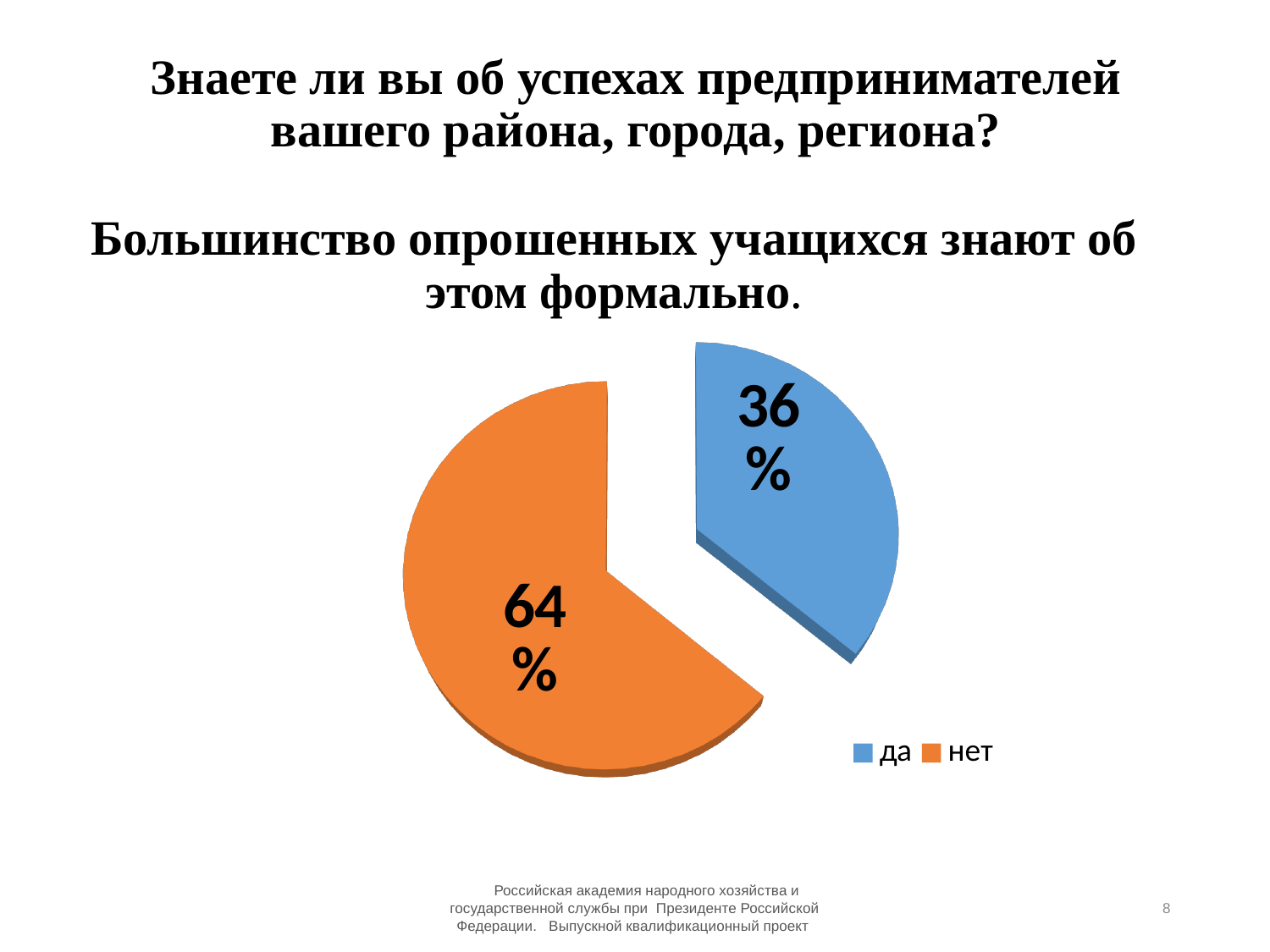
What kind of chart is shown on the slide? pie chart What percentage of respondents answered "да"? 36% Which answer has the largest share of the pie? нет What colour is the "нет" slice? orange What is the difference in percentage points between the "нет" and "да" slices? 28 Which answer has the smallest share of the pie? да Is the share for "да" greater or less than 50%? less How many entries does the legend list? 2 Which slice is larger, "да" or "нет"? нет What colour is the "да" slice? blue What percentage of respondents answered "нет"? 64% How many slices does the pie chart have? 2